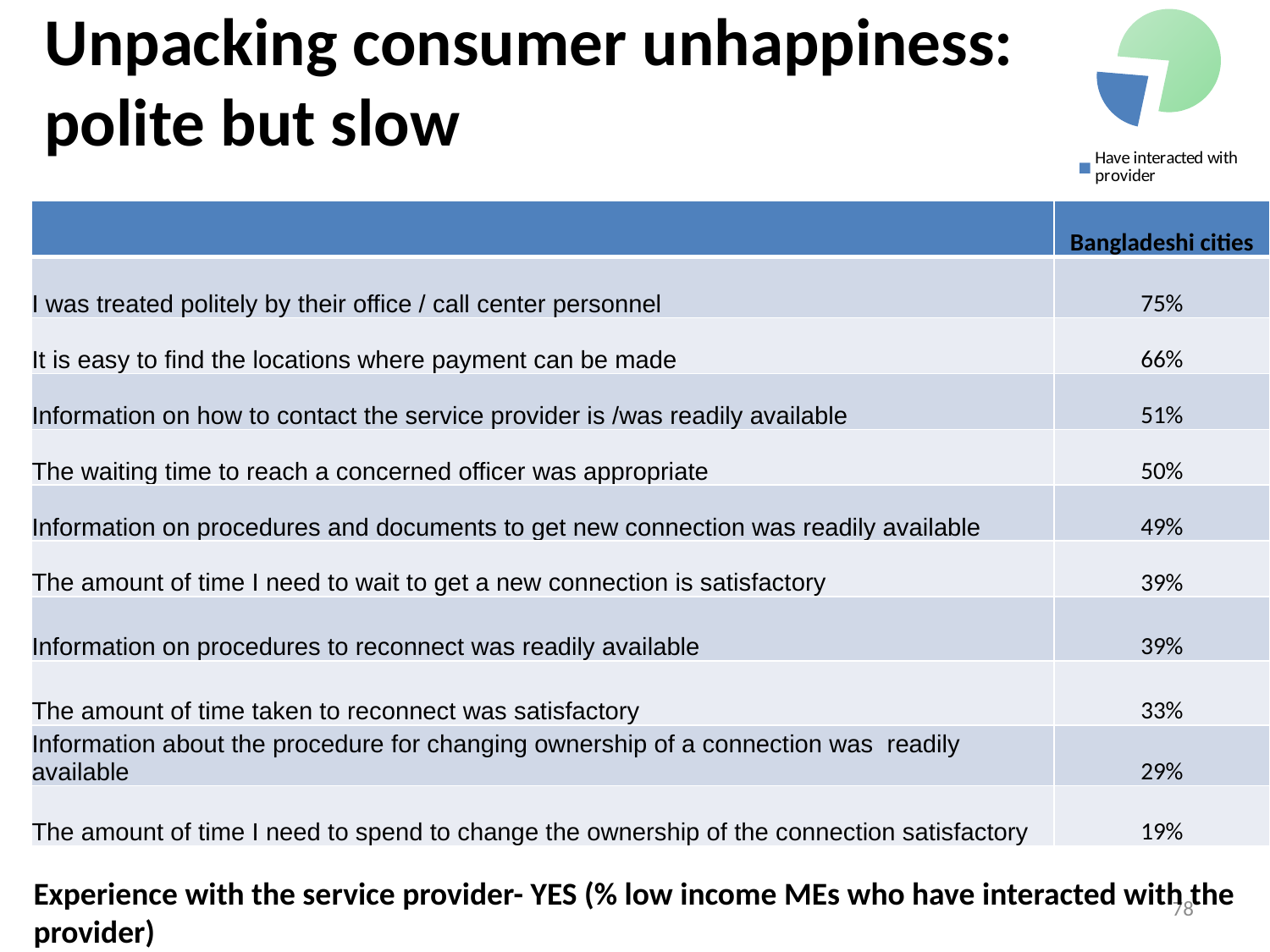
How many entries does the legend of the pie chart list? 1 How many slices does the pie chart in the top right corner have? 2 What is the legend entry shown below the pie chart? Have interacted with provider What colour is the 'Have interacted with provider' slice in the pie chart? blue In the pie chart, which slice is larger, the green one or the blue one? the green one What kind of chart is shown in the top right corner of the slide? pie chart